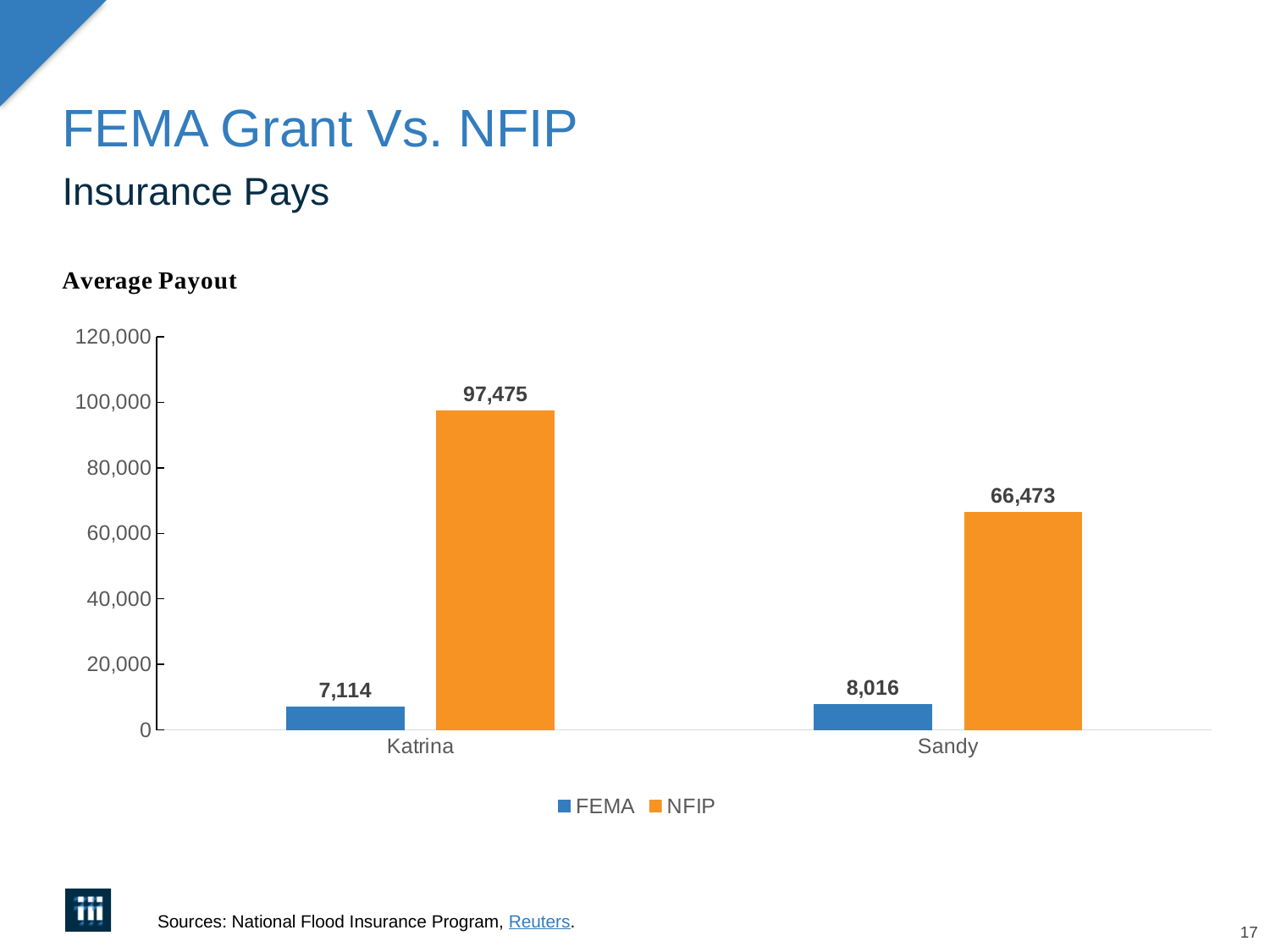
What is the average FEMA payout for Katrina? 7,114 Which bar shows the highest average payout on the chart? NFIP for Katrina What is the average NFIP payout for Katrina? 97,475 Which is larger, the FEMA average payout for Katrina or for Sandy? Sandy What is the title of the chart? Average Payout How many series does the legend list? 2 What is the difference between the NFIP and FEMA average payouts for Katrina? 90,361 What is the average FEMA payout for Sandy? 8,016 Which bar shows the lowest average payout on the chart? FEMA for Katrina What kind of chart is shown on the slide? Bar chart What is the average NFIP payout for Sandy? 66,473 What is the difference between the NFIP average payouts for Katrina and Sandy? 31,002